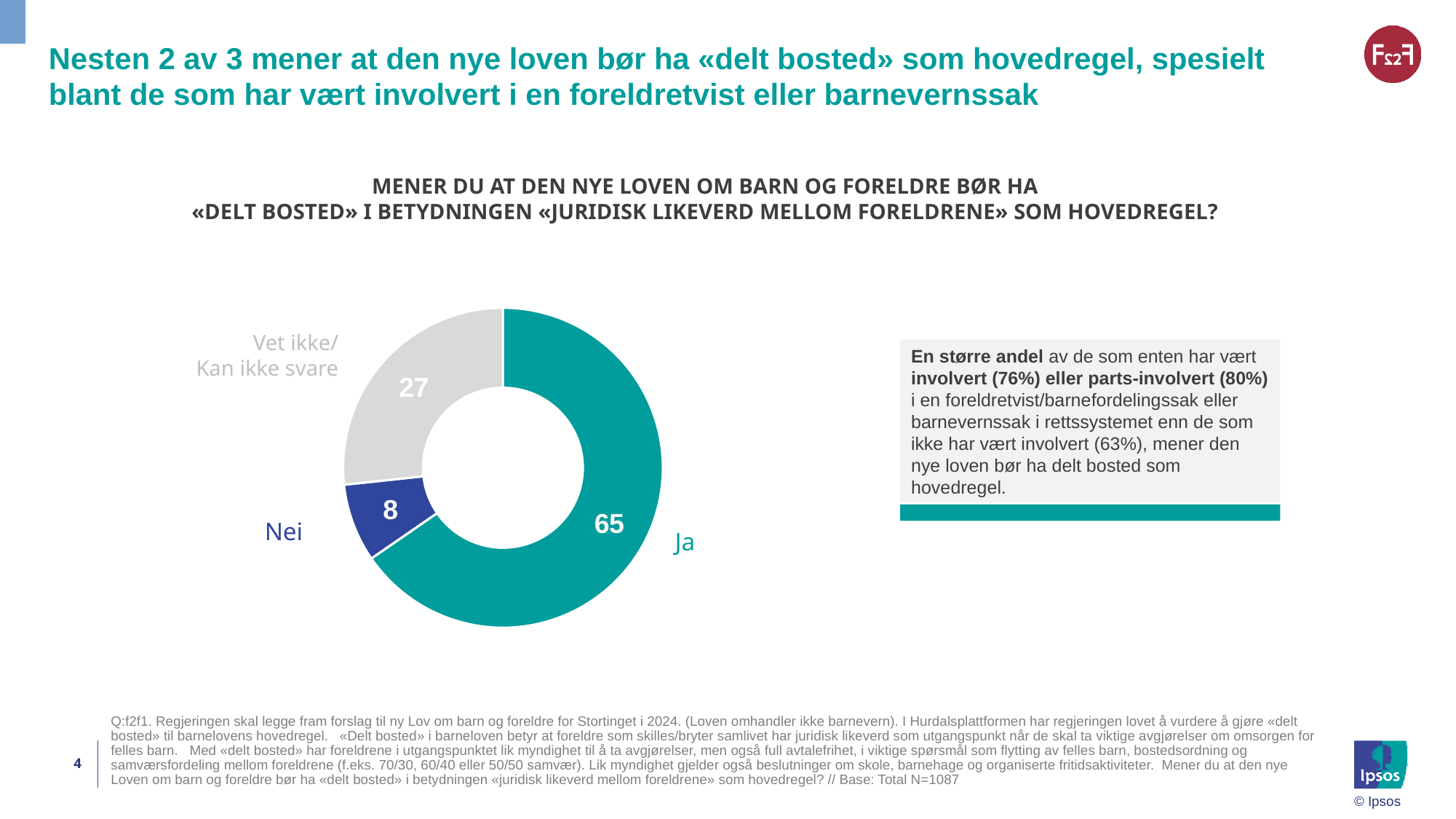
Which category has the largest slice? Ja What is the total of the three values shown in the chart? 100 What is the difference between the values for "Ja" and "Nei"? 57 What colour is the "Nei" slice? Dark blue Which is larger, the value for "Vet ikke/Kan ikke svare" or the value for "Nei"? Vet ikke/Kan ikke svare What is the value for "Vet ikke/Kan ikke svare"? 27 Which category has the smallest slice? Nei What is the value for "Ja"? 65 What is the value for "Nei"? 8 What kind of chart is shown on the slide? Pie chart (donut) How many categories does the chart show? 3 What is the difference between the values for "Vet ikke/Kan ikke svare" and "Nei"? 19